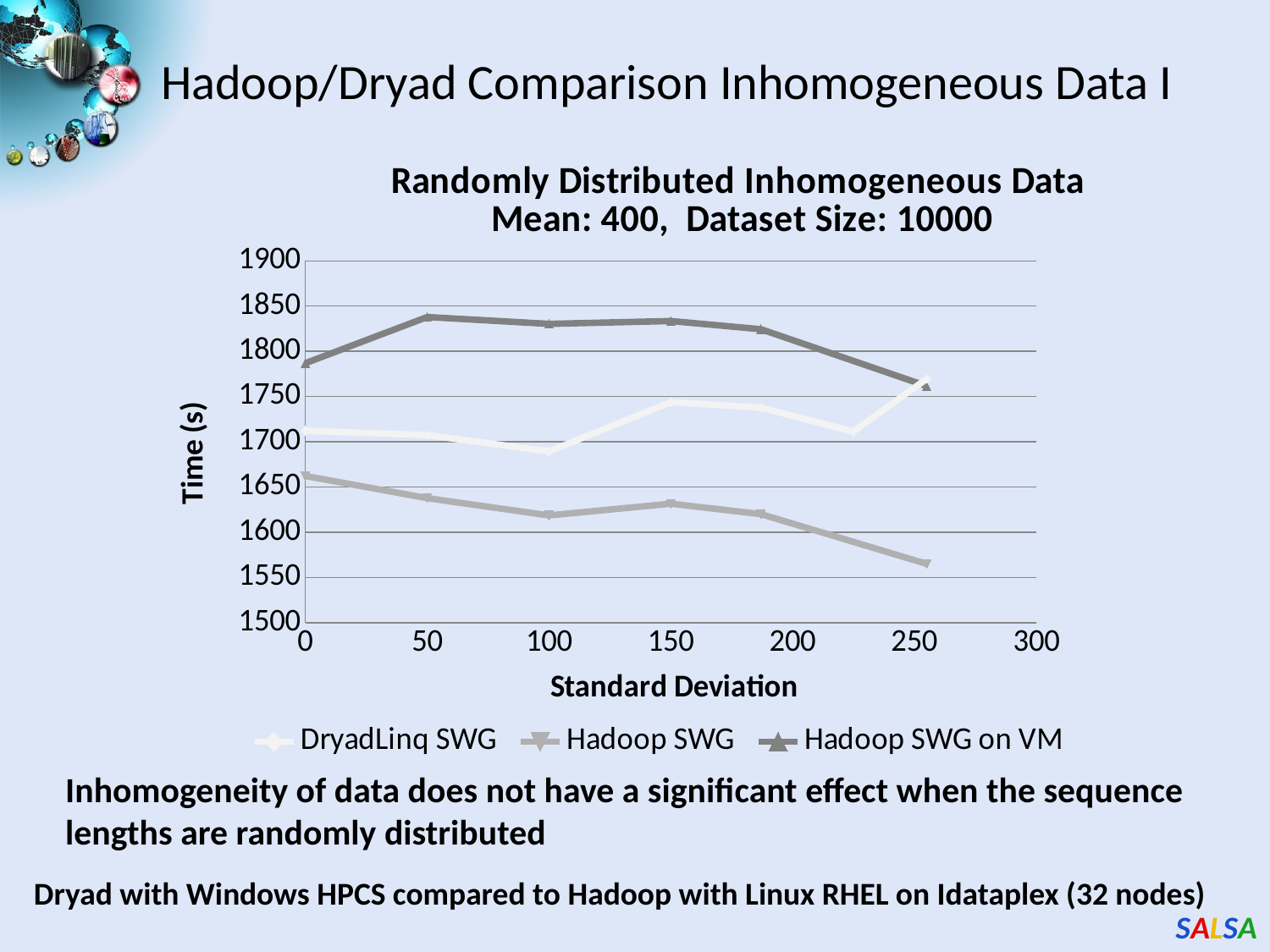
Is the Hadoop SWG on VM time at a standard deviation of 50 greater or less than 1800? greater At a standard deviation of 0, which series has the higher time: Hadoop SWG or Hadoop SWG on VM? Hadoop SWG on VM Which series has the highest Time (s) values across the chart? Hadoop SWG on VM Is the Hadoop SWG time at a standard deviation of 0 greater or less than 1700? less How many series does the chart legend list? 3 Does the Hadoop SWG line generally rise or fall as standard deviation increases? fall Is the DryadLinq SWG time at a standard deviation of 150 greater or less than 1700? greater What is the label of the y axis? Time (s) What is the label of the x axis? Standard Deviation At a standard deviation of 150, which series has the higher time: DryadLinq SWG or Hadoop SWG? DryadLinq SWG Which series has the lowest Time (s) values across the chart? Hadoop SWG What kind of chart is shown on the slide? Line chart